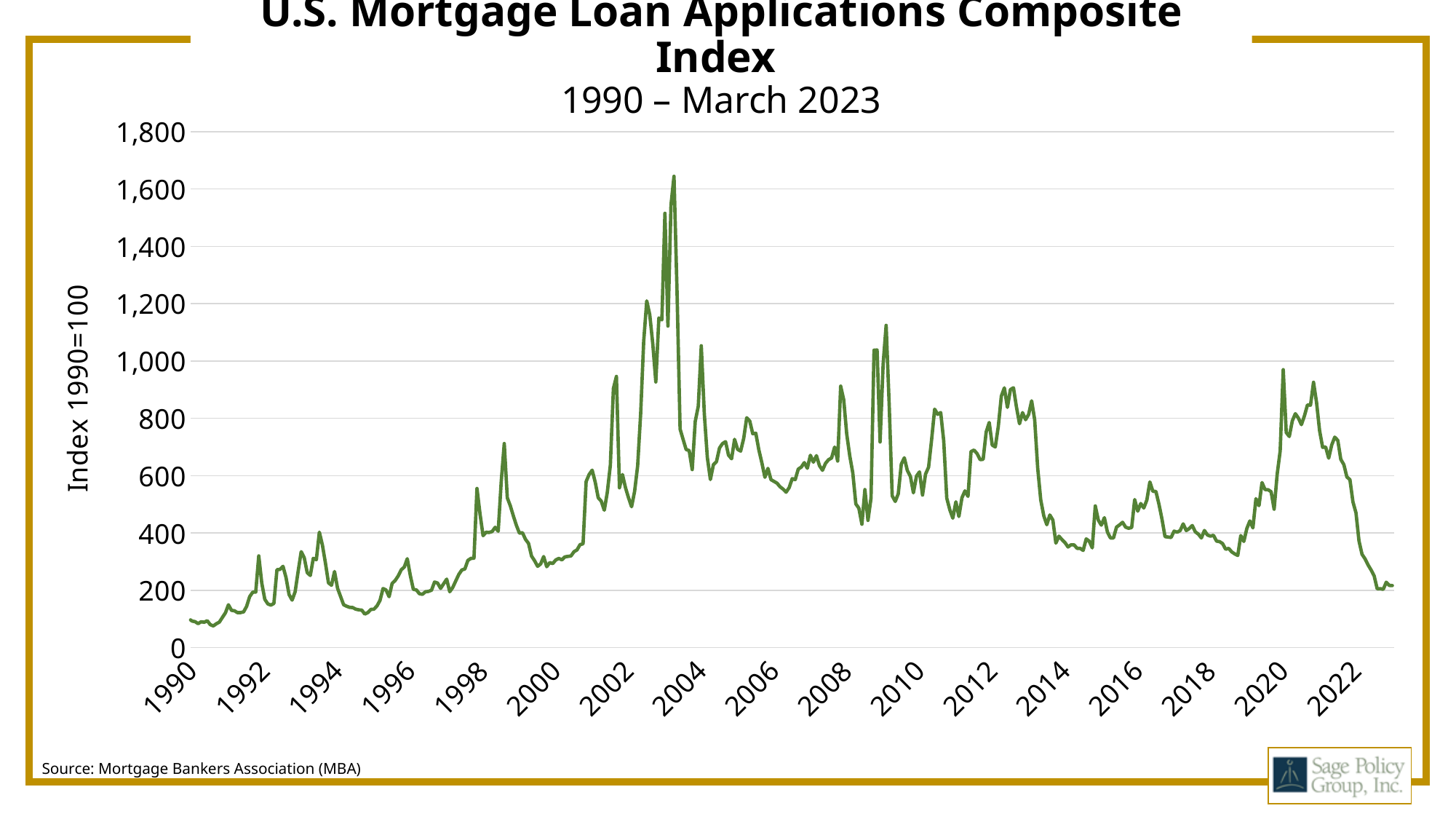
Overall, does the index rise or fall from 1990 to 2003? rise In which year does the index reach its highest peak? 2003 How many lines are plotted on the chart? 1 Is the value of the index at the end of the series, in early 2023, greater or less than 400? less Is the highest peak of the index, around 2003, greater or less than 1,400? greater Is the value of the index at the start of 1990 greater or less than 200? less From 2021 to early 2023, does the index rise or fall? fall What is the title of the chart? U.S. Mortgage Loan Applications Composite Index What kind of chart is shown on the slide? line chart What is the label on the vertical axis of the chart? Index 1990=100 Which is higher: the peak of the index around 2003 or the peak around 2009? 2003